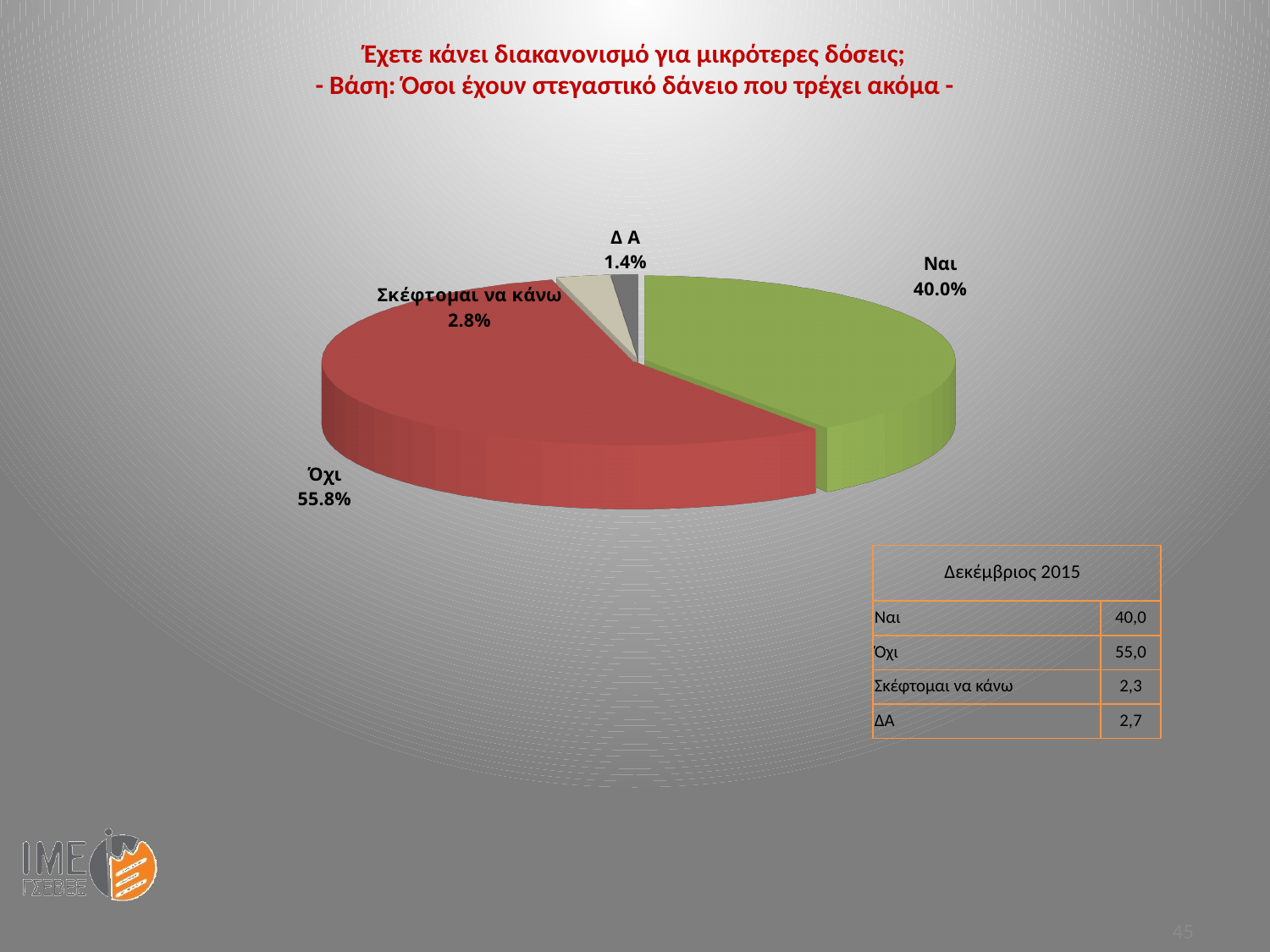
What is the difference in percentage points between the "Όχι" slice and the "Ναι" slice? 15.8 What percentage of the pie chart is labelled "Δ Α"? 1.4% What colour is the "Όχι" slice of the pie chart? Red Which slice of the pie chart is the smallest? Δ Α Which slice of the pie chart is the largest? Όχι What kind of chart is shown on the slide? Pie chart What percentage of the pie chart is labelled "Σκέφτομαι να κάνω"? 2.8% What colour is the "Ναι" slice of the pie chart? Green Which slice is larger, "Σκέφτομαι να κάνω" or "Δ Α"? Σκέφτομαι να κάνω How many slices does the pie chart have? 4 What percentage of the pie chart is labelled "Όχι"? 55.8% What percentage of the pie chart is labelled "Ναι"? 40.0%